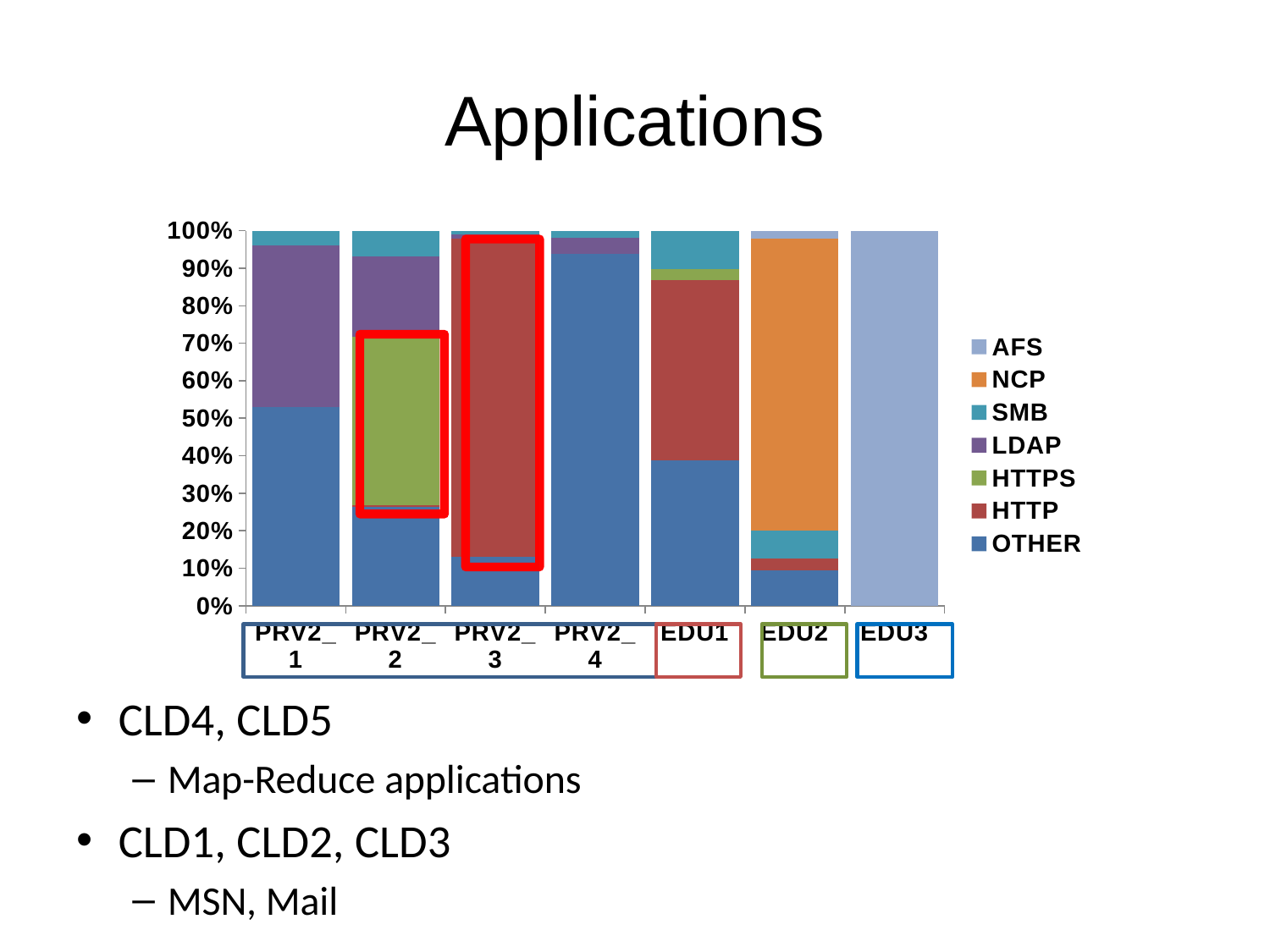
What is the title of the chart? Applications Which category has the larger OTHER share, PRV2_3 or PRV2_4? PRV2_4 Is the OTHER share for EDU2 greater or less than 20%? less Is the OTHER share for PRV2_1 greater or less than 40%? greater Which category has the largest OTHER share? PRV2_4 How many categories are shown along the x axis of the chart? 7 What kind of chart is shown on the slide? stacked bar chart How many series does the chart's legend list? 7 Is the OTHER share for PRV2_4 greater or less than 80%? greater Which series is shown in orange in the chart's legend? NCP